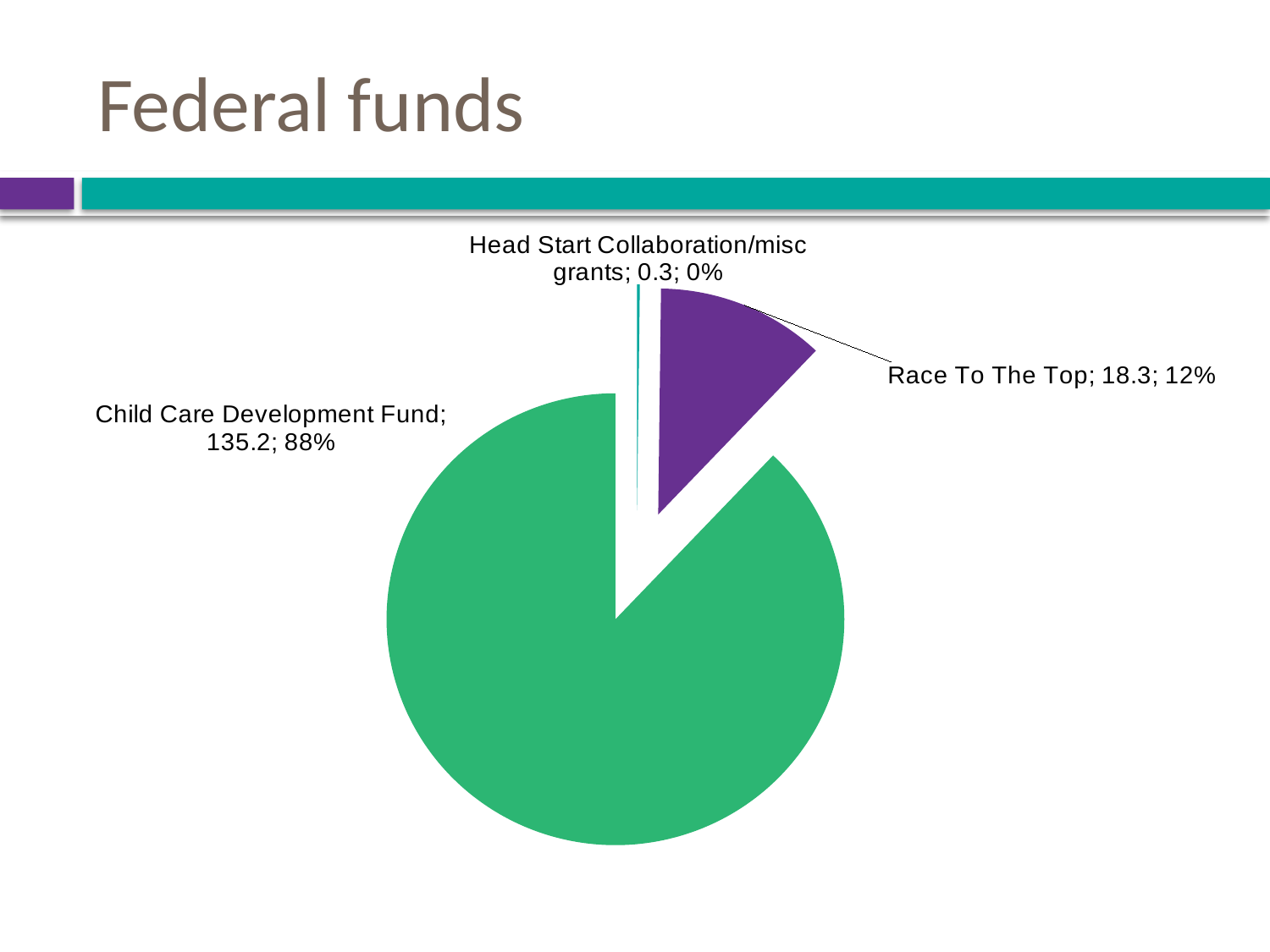
What is the difference between the values for Child Care Development Fund and Race To The Top? 116.9 What kind of chart is shown on the slide? pie chart Which is larger, Race To The Top or Head Start Collaboration/misc grants? Race To The Top Which category has the smallest slice? Head Start Collaboration/misc grants What share of the pie does Child Care Development Fund represent? 88% How many slices does the pie chart have? 3 What is the value for Child Care Development Fund? 135.2 What is the title of the slide containing the chart? Federal funds Which category has the largest slice? Child Care Development Fund What is the value for Race To The Top? 18.3 What share of the pie does Race To The Top represent? 12% What is the value for Head Start Collaboration/misc grants? 0.3